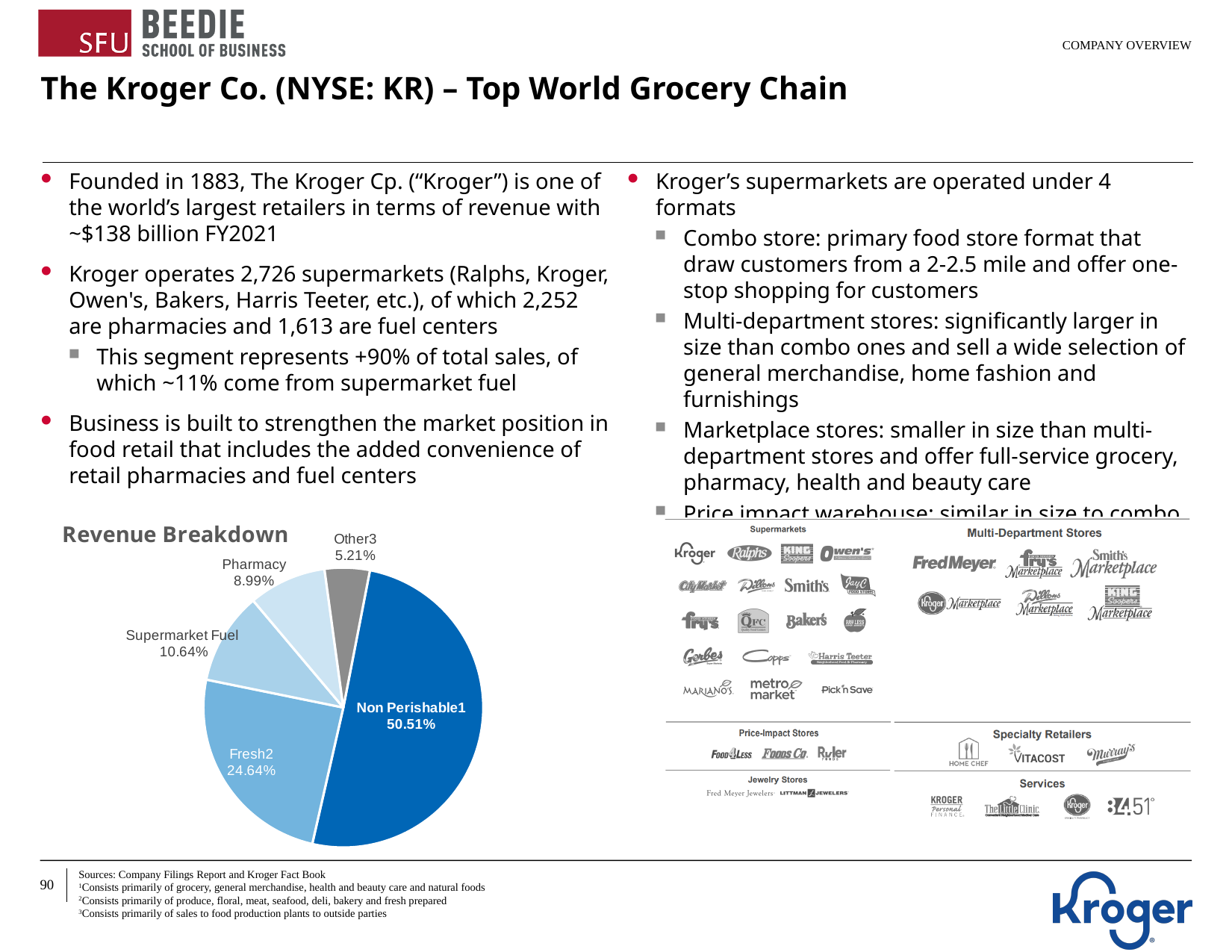
What share of revenue does the Non Perishable slice represent in the Revenue Breakdown chart? 50.51% In the Revenue Breakdown chart, which is larger: Supermarket Fuel or Pharmacy? Supermarket Fuel What is the title of the pie chart on the slide? Revenue Breakdown What kind of chart is the Revenue Breakdown chart? Pie chart What share of revenue does the Other slice represent in the Revenue Breakdown chart? 5.21% What share of revenue does the Fresh slice represent in the Revenue Breakdown chart? 24.64% How many slices does the Revenue Breakdown pie chart have? 5 What share of revenue does Supermarket Fuel represent in the Revenue Breakdown chart? 10.64% Which category has the largest share in the Revenue Breakdown chart? Non Perishable What share of revenue does Pharmacy represent in the Revenue Breakdown chart? 8.99% In the Revenue Breakdown chart, what is the difference in percentage points between the Non Perishable and Fresh shares? 25.87 Which category has the smallest share in the Revenue Breakdown chart? Other